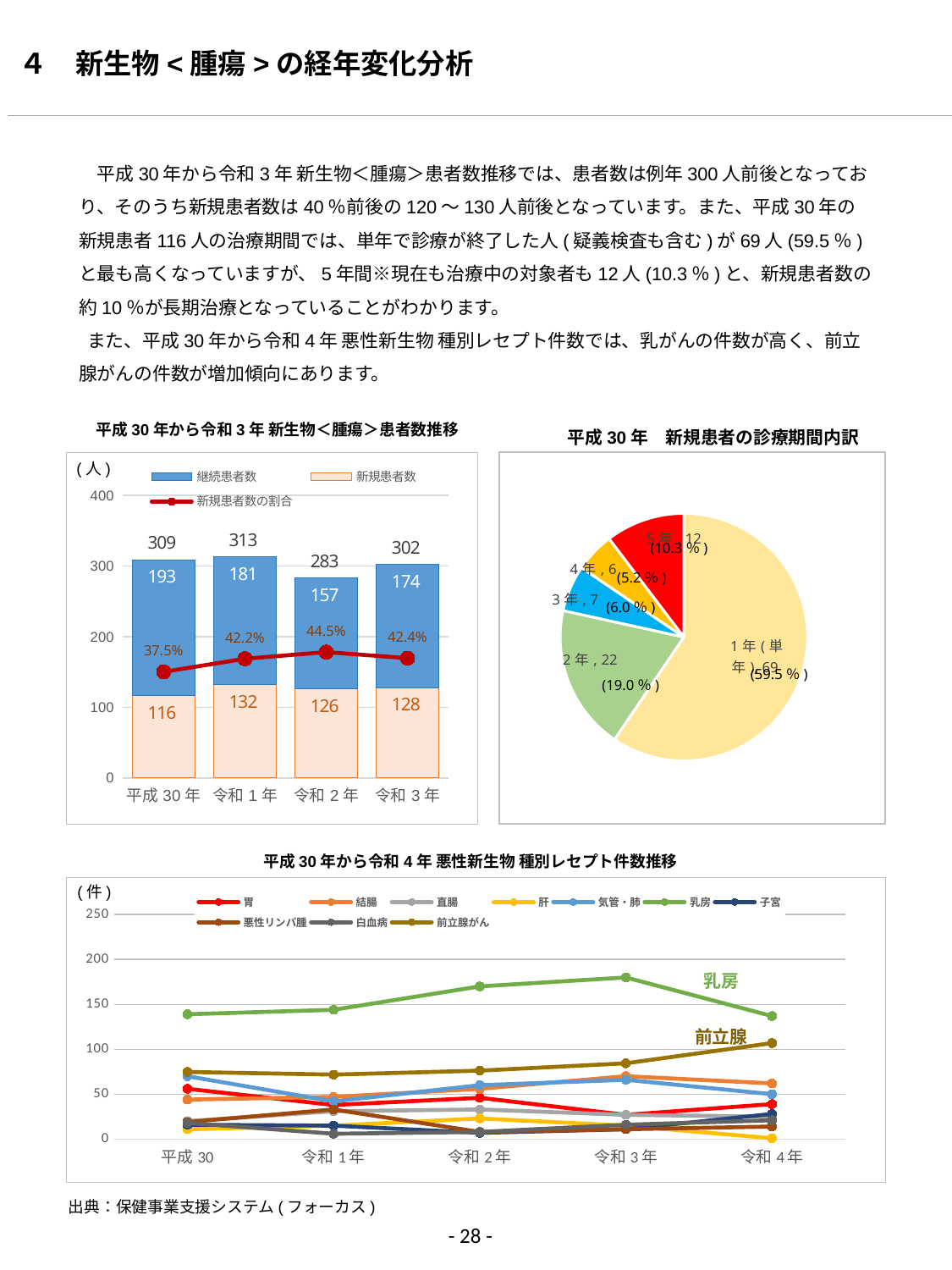
In the pie chart titled 平成30年 新規患者の診療期間内訳, which category has the smallest slice? 4年 In the chart titled 平成30年から令和3年 新生物＜腫瘍＞患者数推移, what is the 新規患者数 for 令和1年? 132 In the chart titled 平成30年から令和3年 新生物＜腫瘍＞患者数推移, what is the difference between the 継続患者数 for 平成30年 and 令和3年? 19 What kind of chart is the one titled 平成30年から令和4年 悪性新生物 種別レセプト件数推移? line chart In the chart titled 平成30年から令和4年 悪性新生物 種別レセプト件数推移, how many series does the legend list? 10 In the chart titled 平成30年から令和3年 新生物＜腫瘍＞患者数推移, what is the 新規患者数の割合 for 平成30年? 37.5% In the pie chart titled 平成30年 新規患者の診療期間内訳, what share does the 2年 slice represent? 19.0% In the chart titled 平成30年から令和4年 悪性新生物 種別レセプト件数推移, is the value for 乳房 in 令和3年 greater or less than 150? greater In the pie chart titled 平成30年 新規患者の診療期間内訳, what is the value for 4年? 6 In the chart titled 平成30年から令和3年 新生物＜腫瘍＞患者数推移, which year has the highest total patient count? 令和1年 In the chart titled 平成30年から令和3年 新生物＜腫瘍＞患者数推移, how many series does the legend list? 3 In the chart titled 平成30年から令和3年 新生物＜腫瘍＞患者数推移, what is the 継続患者数 for 令和2年? 157